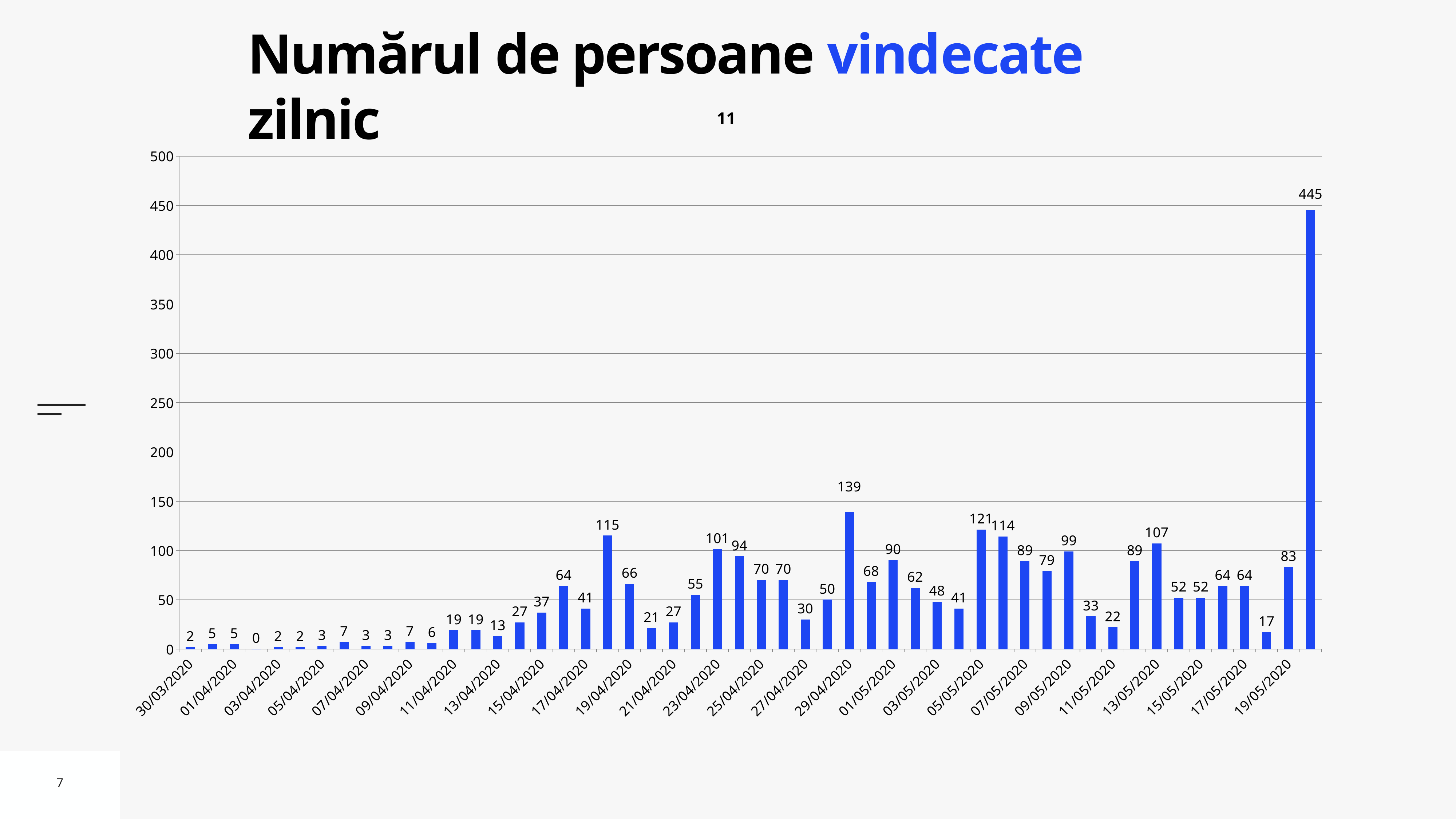
What kind of chart is shown on the slide? bar chart Is the value of the tallest bar greater or less than 400? greater What is the lowest daily value shown in the chart? 0 What is the value for 29/04/2020? 139 What is the title of the chart? 11 What is the difference between the highest bar (445) and the value for 29/04/2020? 306 What is the value for 05/05/2020? 121 Which date has the larger value, 29/04/2020 or 05/05/2020? 29/04/2020 What is the value for 13/05/2020? 107 What is the highest daily value shown in the chart? 445 What is the value for 23/04/2020? 101 What is the value for 19/05/2020? 83